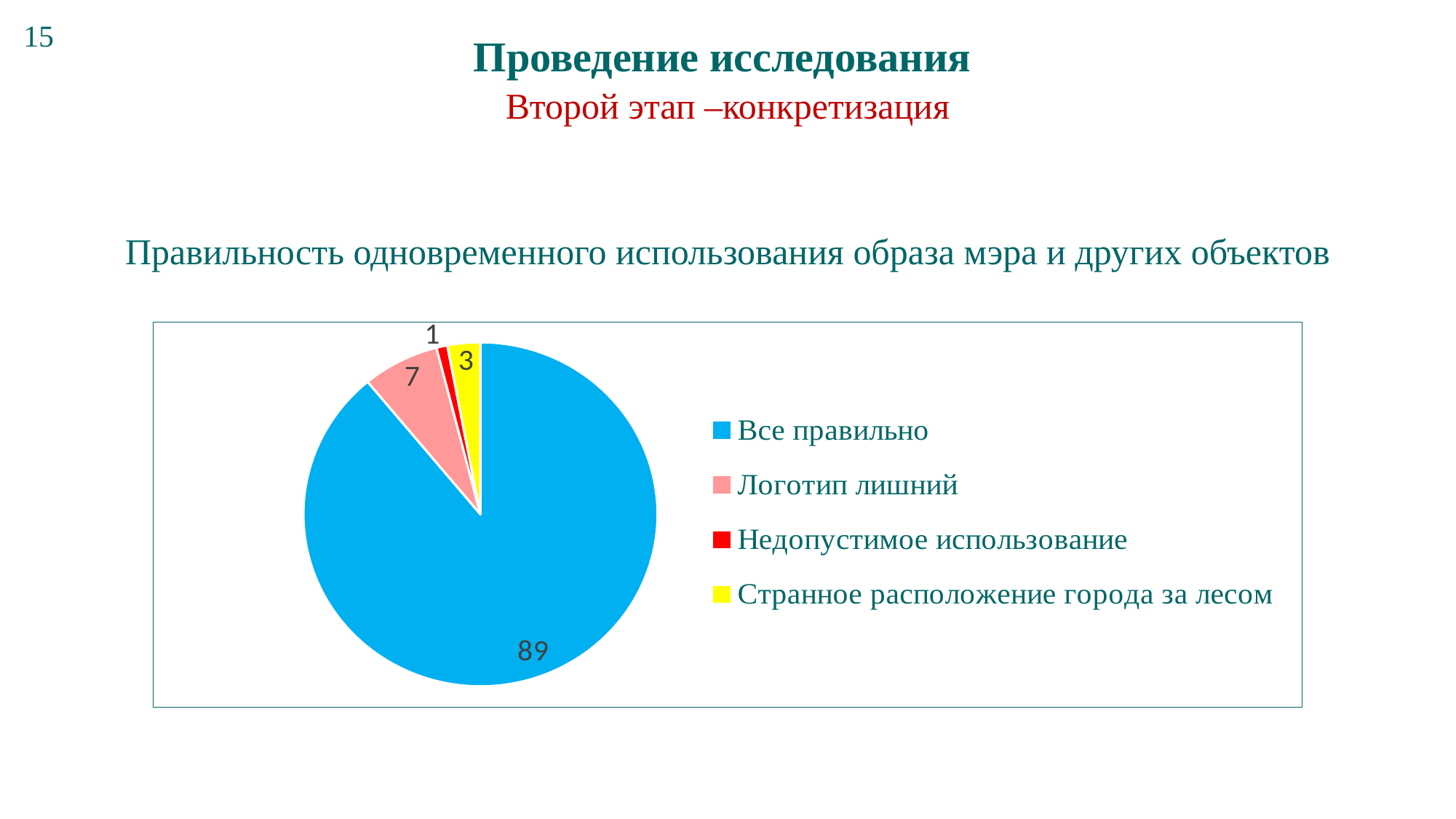
What is the difference between the values for "Все правильно" and "Логотип лишний"? 82 What is the value for "Все правильно" in the pie chart? 89 What colour is the slice for "Странное расположение города за лесом"? Yellow Which category has the smallest slice in the pie chart? Недопустимое использование What is the value for "Логотип лишний" in the pie chart? 7 Which is larger: the value for "Логотип лишний" or the value for "Странное расположение города за лесом"? Логотип лишний Which category has the largest slice in the pie chart? Все правильно What is the value for "Недопустимое использование" in the pie chart? 1 What is the value for "Странное расположение города за лесом" in the pie chart? 3 How many categories does the pie chart show? 4 What type of chart is shown on the slide? Pie chart What share of the pie does "Все правильно" represent? 89%